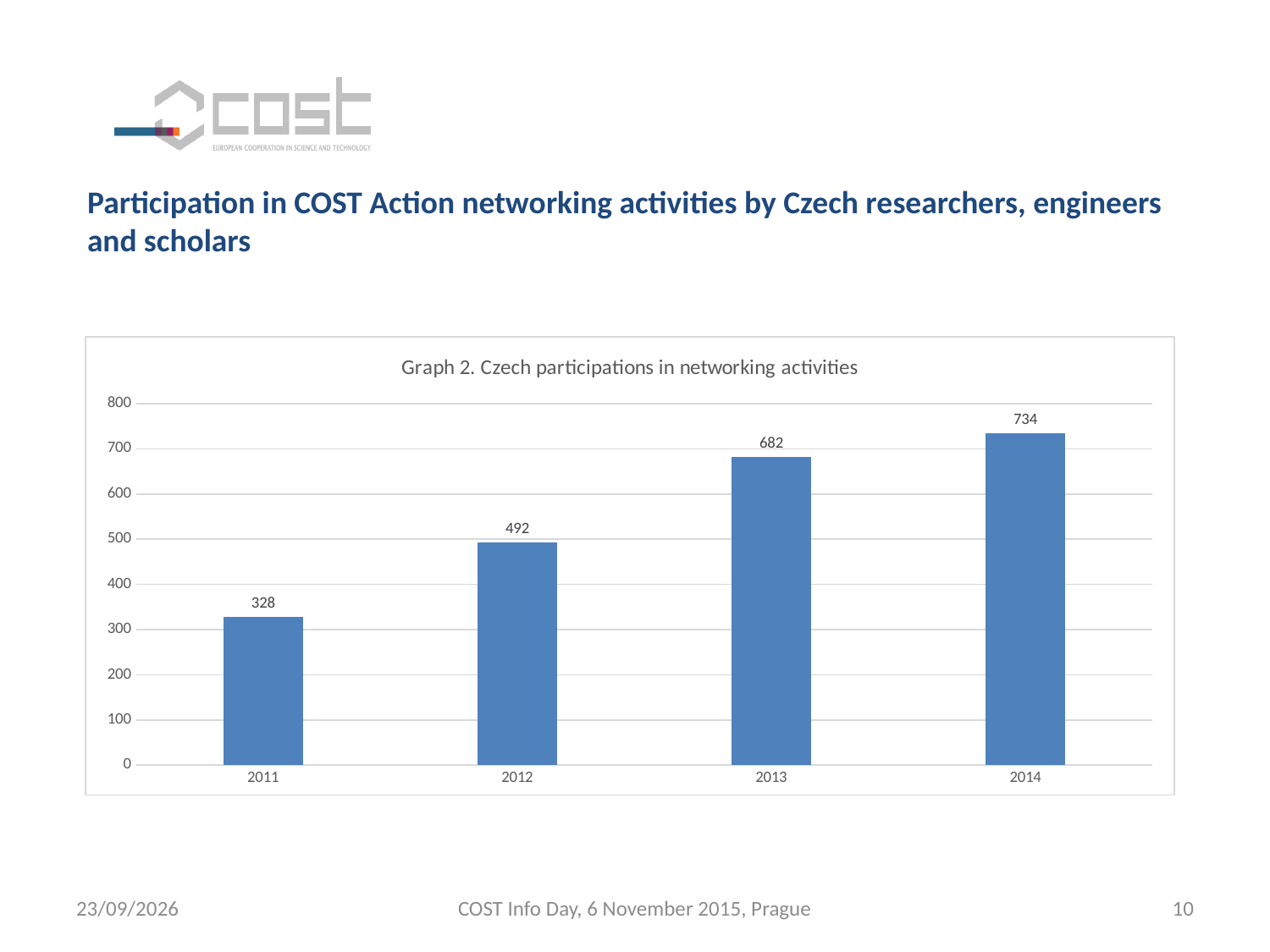
Which year has the highest value? 2014 Which year has the lowest value? 2011 How many years are shown on the x axis? 4 Is the value for 2012 greater or less than 400? greater What kind of chart is shown? bar chart Which is larger, the value for 2012 or the value for 2013? 2013 What is the value for 2013? 682 Do the values rise or fall from 2011 to 2014? rise What is the value for 2014? 734 What is the value for 2011? 328 What is the difference between the values for 2012 and 2011? 164 What is the difference between the values for 2014 and 2013? 52